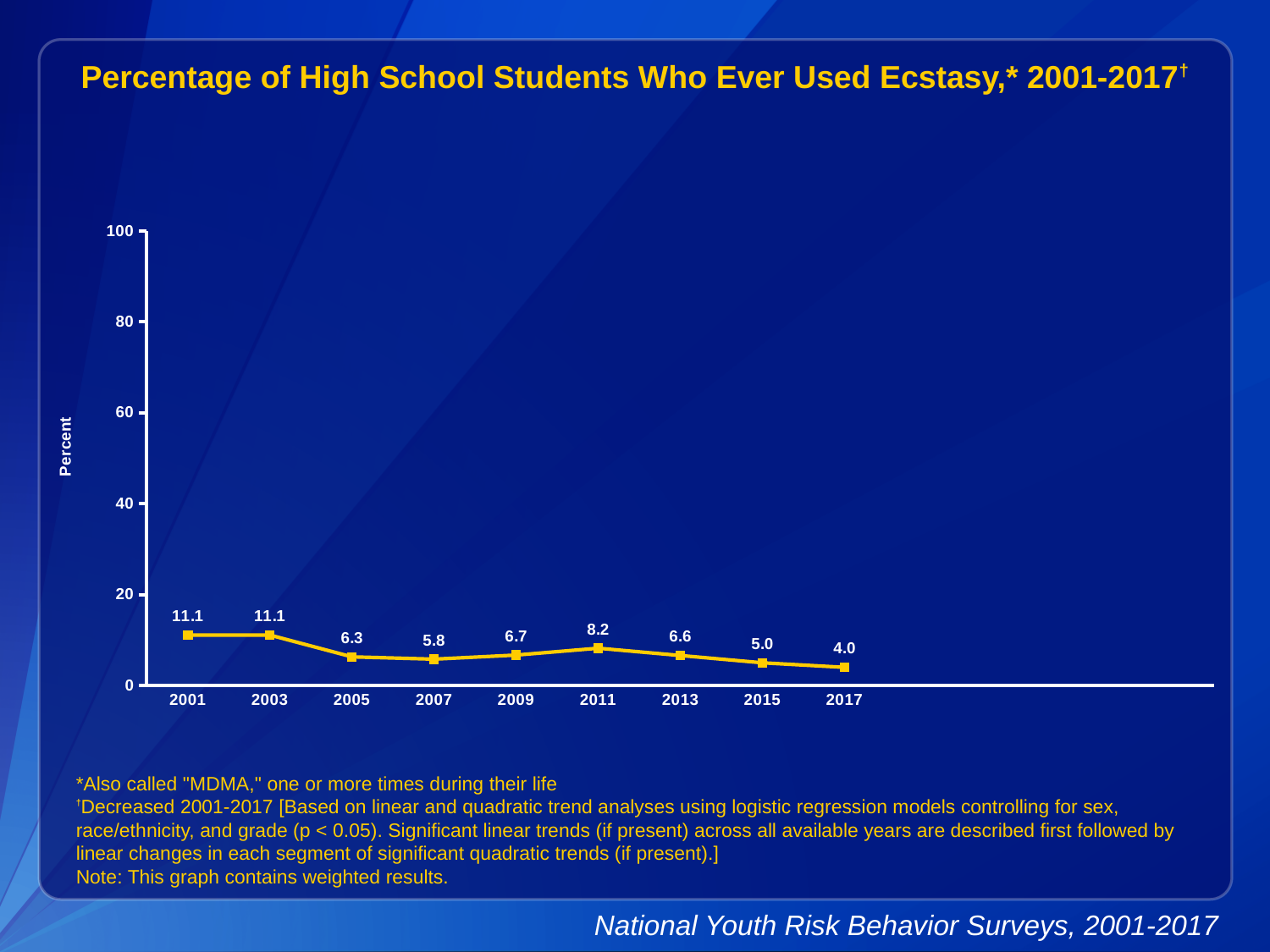
Which is larger, the value for 2009 or the value for 2007? 2009 What is the label on the y axis? Percent What is the difference between the 2001 value and the 2017 value? 7.1 What kind of chart is shown on the slide? line chart Is the value for 2003 greater or less than 20? less What percentage of high school students had ever used ecstasy in 2011? 8.2 What is the value plotted for 2005? 6.3 What is the difference between the 2011 value and the 2013 value? 1.6 Which year has the lowest percentage of students who ever used ecstasy? 2017 What is the value plotted for 2017? 4.0 How many years are plotted on the x axis? 9 Overall, do the values rise or fall from 2001 to 2017? fall